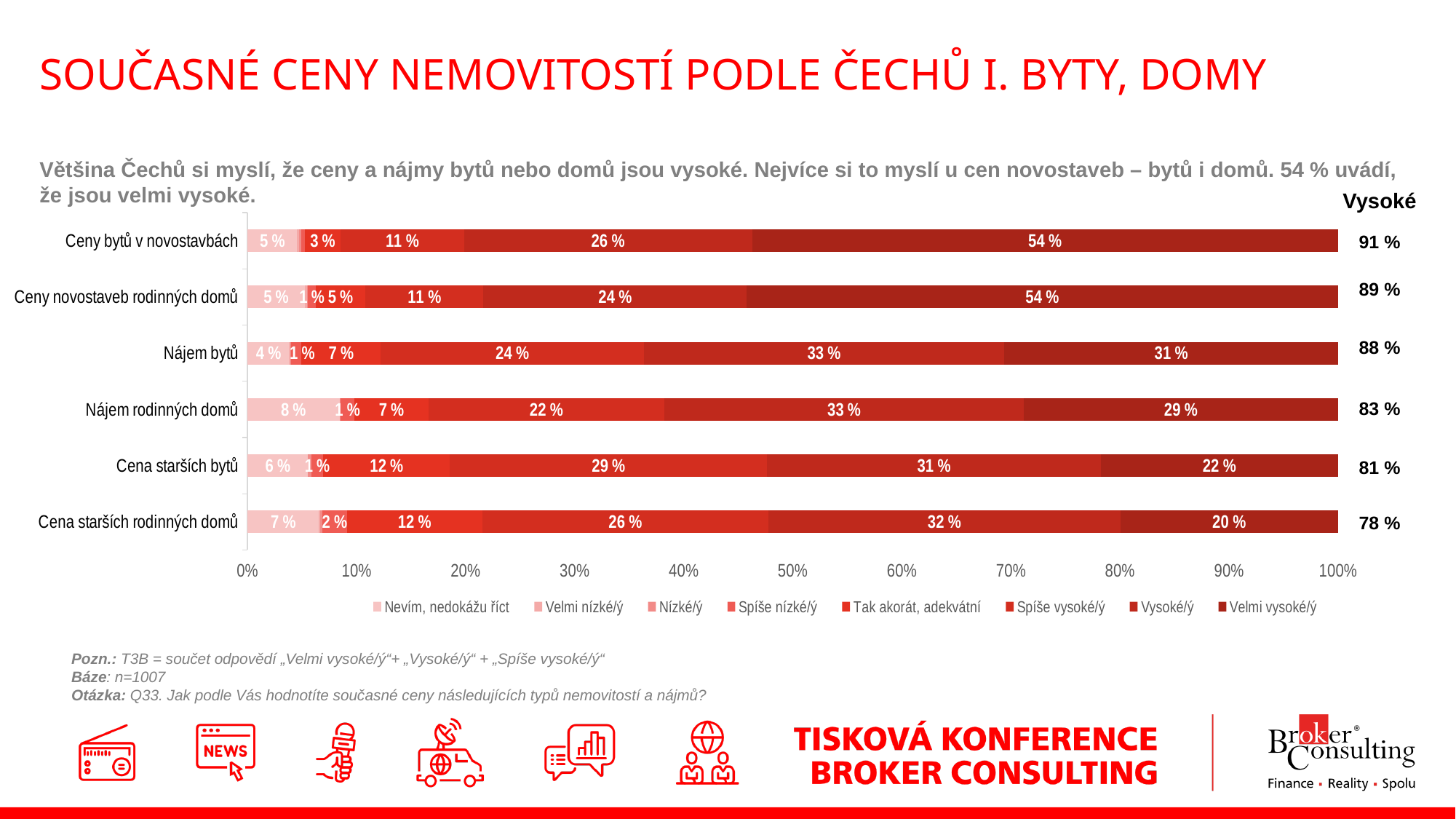
Which category has the highest 'Vysoké' (T3B) total shown at the right of the chart? Ceny bytů v novostavbách Which category has the lowest 'Vysoké' (T3B) total shown at the right of the chart? Cena starších rodinných domů What is the 'Velmi vysoké/ý' (darkest, rightmost segment) value for 'Nájem bytů'? 31 % How many property categories are listed on the chart's vertical axis? 6 What is the 'Vysoké' (T3B) total shown to the right of the bar for 'Nájem rodinných domů'? 83 % What kind of chart is shown on the slide? Stacked bar chart What is the difference between the 'Vysoké' totals for 'Ceny bytů v novostavbách' and 'Cena starších rodinných domů'? 13 percentage points How many series does the chart legend list? 8 What is the 'Nevím, nedokážu říct' (first, leftmost segment) value for 'Nájem rodinných domů'? 8 % What is the 'Velmi vysoké/ý' value for 'Ceny novostaveb rodinných domů'? 54 % Which category has the lowest 'Velmi vysoké/ý' (darkest segment) value? Cena starších rodinných domů Which is larger: the 'Velmi vysoké/ý' value for 'Nájem bytů' or for 'Cena starších bytů'? Nájem bytů